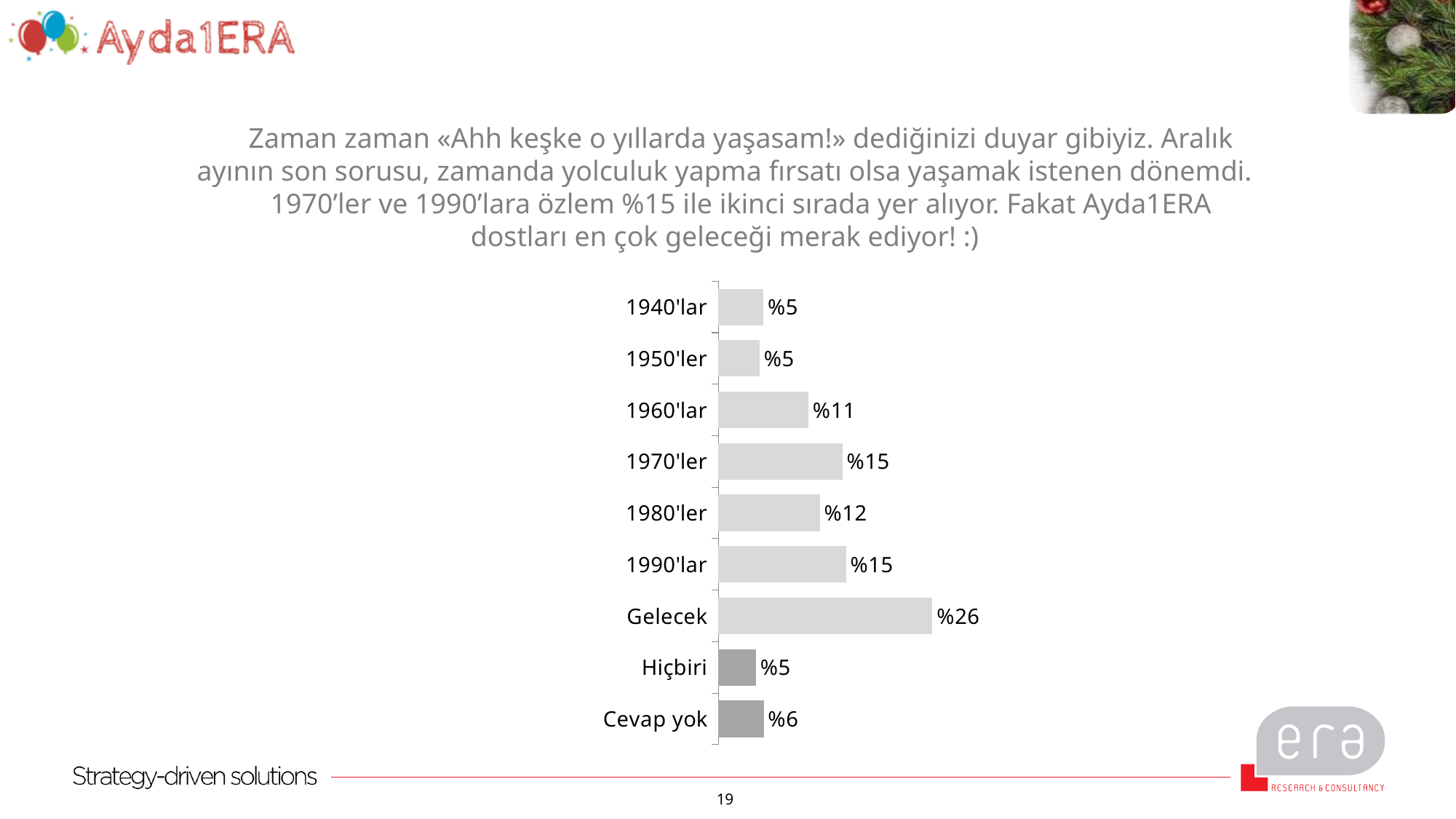
What is the difference between the values for Gelecek and 1970'ler? %11 How many categories are shown in the chart? 9 What is the value for 1960'lar? %11 How many categories have a value of %5? 3 What is the value for Gelecek? %26 What is the value for Cevap yok? %6 What kind of chart is shown on the slide? Bar chart What is the difference between the values for 1980'ler and 1960'lar? %1 Which is larger, the value for Hiçbiri or the value for Cevap yok? Cevap yok What is the value for 1980'ler? %12 Which is larger, the value for 1960'lar or the value for 1980'ler? 1980'ler Which category has the highest value? Gelecek